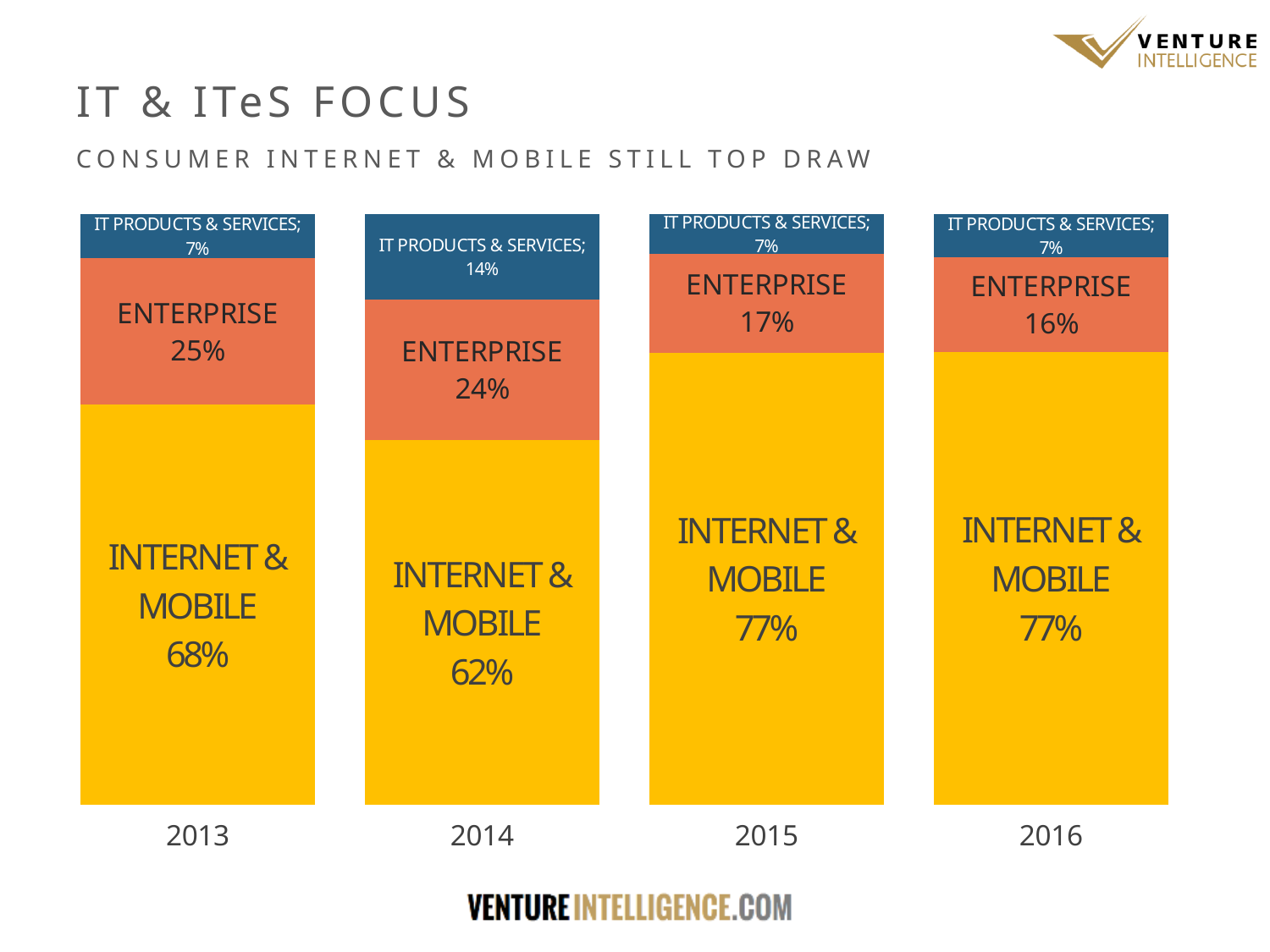
In which year was the Enterprise share highest? 2013 How many years are shown on the x axis? 4 What share did Internet & Mobile have in 2013? 68% Which was larger in 2013: the Enterprise share or the IT Products & Services share? Enterprise In which year was the Internet & Mobile share lowest? 2014 What share did Enterprise have in 2016? 16% What is the difference between the Internet & Mobile share in 2015 and in 2014? 15% What share did IT Products & Services have in 2014? 14% What share did Enterprise have in 2014? 24% How many segments make up each stacked bar? 3 What kind of chart is shown on the slide? Stacked bar chart What is the subtitle of the slide below 'IT & ITeS FOCUS'? CONSUMER INTERNET & MOBILE STILL TOP DRAW